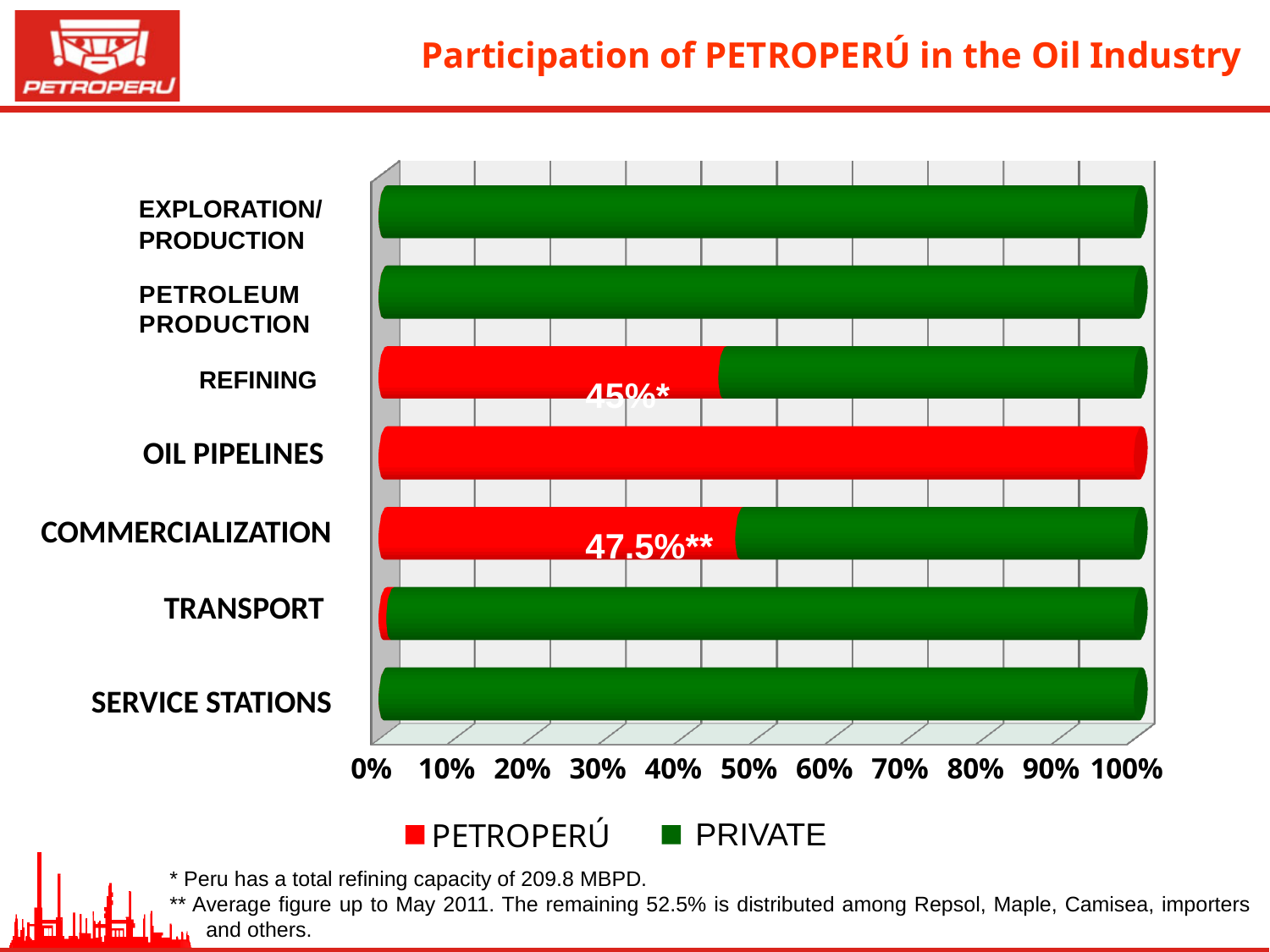
Which category has the largest PETROPERÚ share? OIL PIPELINES Is the PETROPERÚ share for TRANSPORT greater or less than 10%? less What kind of chart is shown on the slide? Bar chart Which colour represents PETROPERÚ in the legend? Red Which has the larger PETROPERÚ share, REFINING or COMMERCIALIZATION? COMMERCIALIZATION How many categories are listed on the vertical axis of the chart? 7 How many series does the legend list? 2 Is the PETROPERÚ share for OIL PIPELINES greater or less than 90%? greater What is the PETROPERÚ share shown for COMMERCIALIZATION? 47.5% What is the PETROPERÚ share shown for REFINING? 45% What is the title of the slide containing the chart? Participation of PETROPERÚ in the Oil Industry What is the difference between the PETROPERÚ share in COMMERCIALIZATION and in REFINING? 2.5%